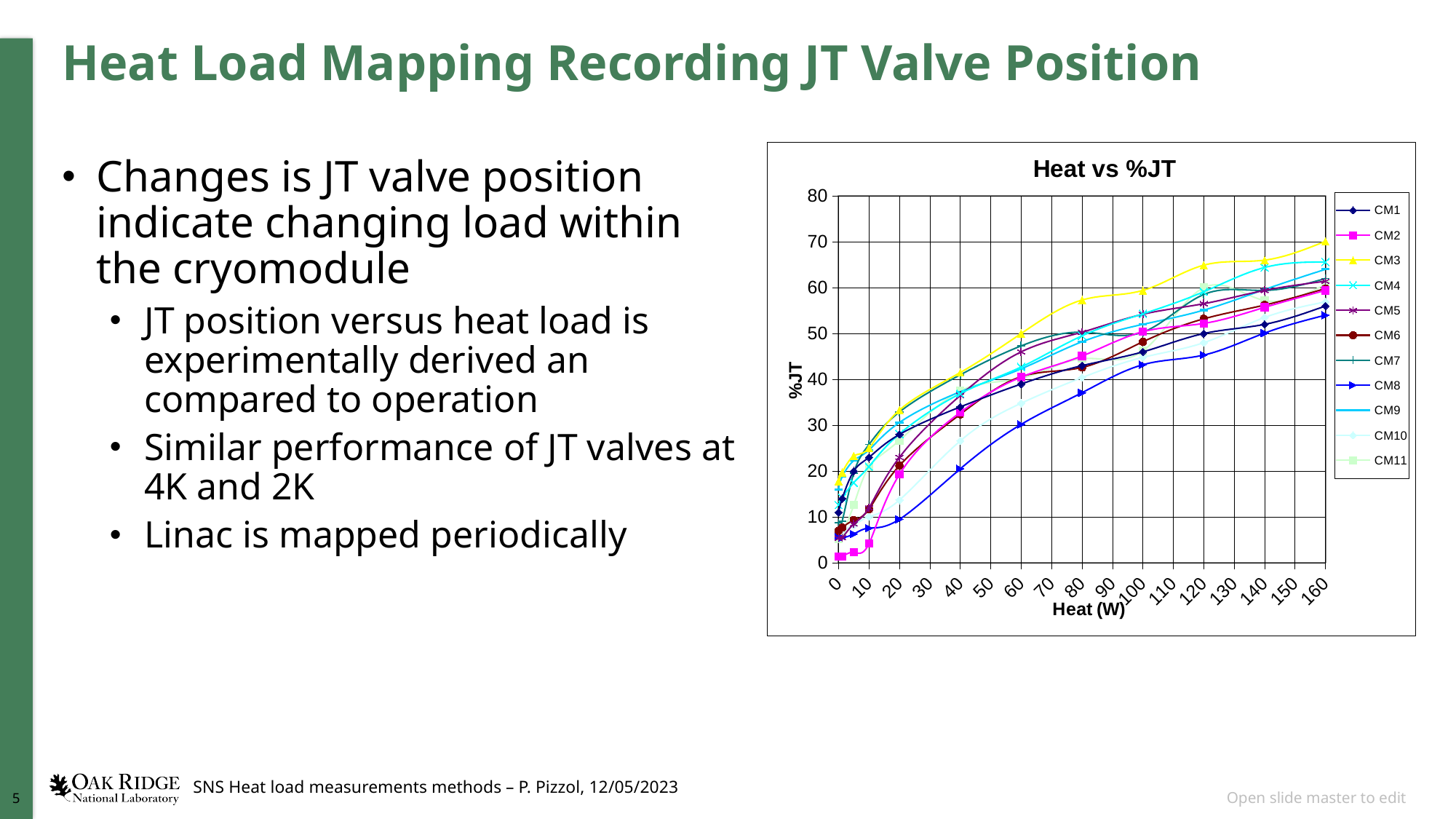
Is the %JT value for CM8 at 160 W greater or less than 60? less Which series has the lowest %JT value at 0 W? CM2 Is the %JT value for CM3 at 160 W greater or less than 60? greater How many series does the legend of the "Heat vs %JT" chart list? 11 Is the %JT value for CM2 at 10 W greater or less than 10? less What kind of chart is shown on the slide? line chart What is the label of the x axis of the chart? Heat (W) What is the title of the chart on the slide? Heat vs %JT Which series has the highest %JT value at 160 W? CM3 At 160 W, which series has the larger %JT value, CM3 or CM8? CM3 Do the %JT values for CM3 rise or fall as heat increases along the x axis? rise